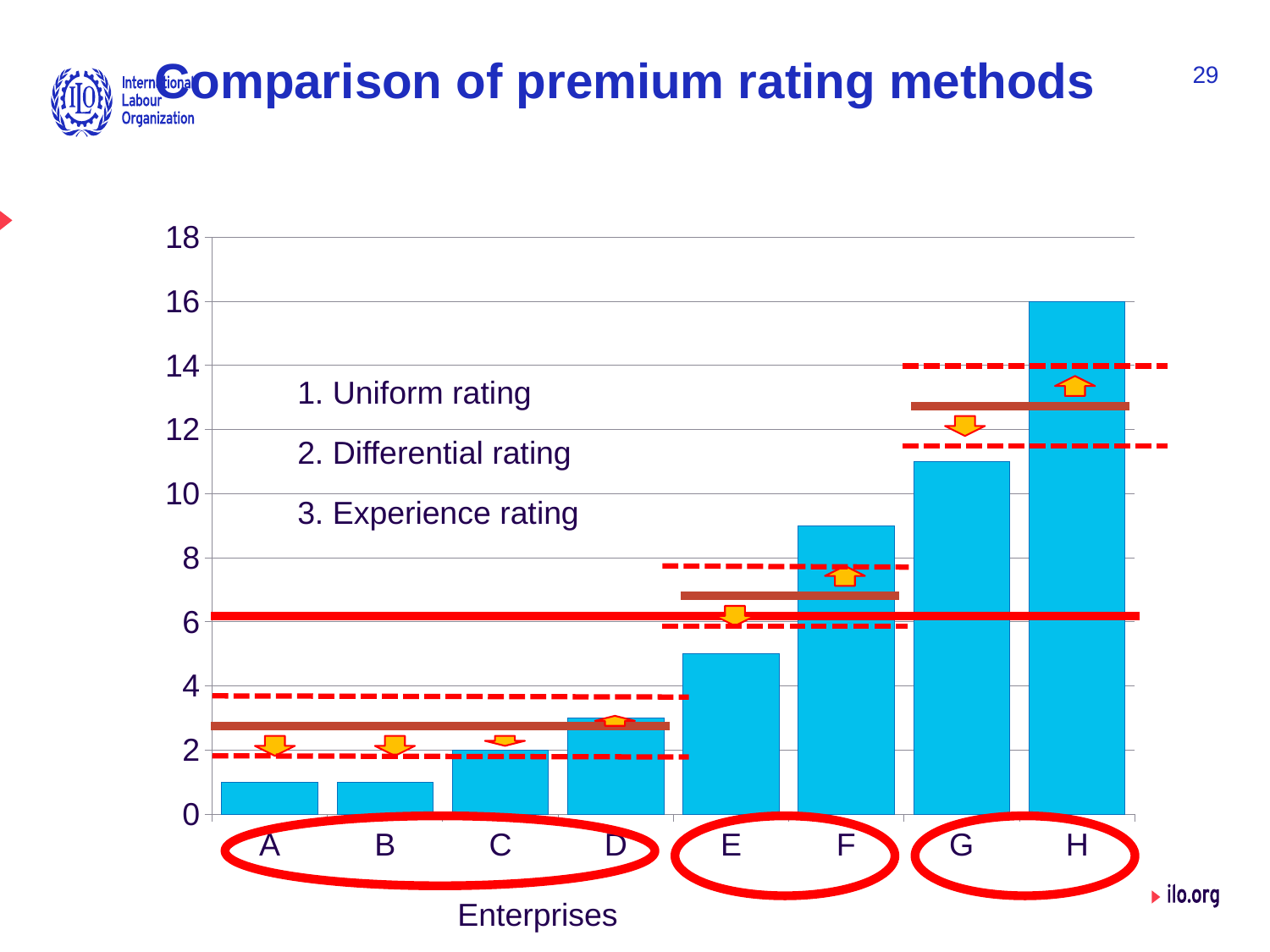
What is the label of the x axis of the chart? Enterprises Do the bar values rise or fall from enterprise A to enterprise H? rise Is the value for enterprise G greater or less than 10? greater Is the value for enterprise F greater or less than 8? greater What is the value of the bar for enterprise C? 2 What is the value of the bar for enterprise H? 16 What is the difference between the bar values for enterprises H and C? 14 Is the value for enterprise E greater or less than 6? less Which enterprise has the highest bar in the chart? H Which enterprise has the larger bar, E or F? F How many enterprises are plotted on the x axis of the chart? 8 What kind of chart is shown on the slide? bar chart